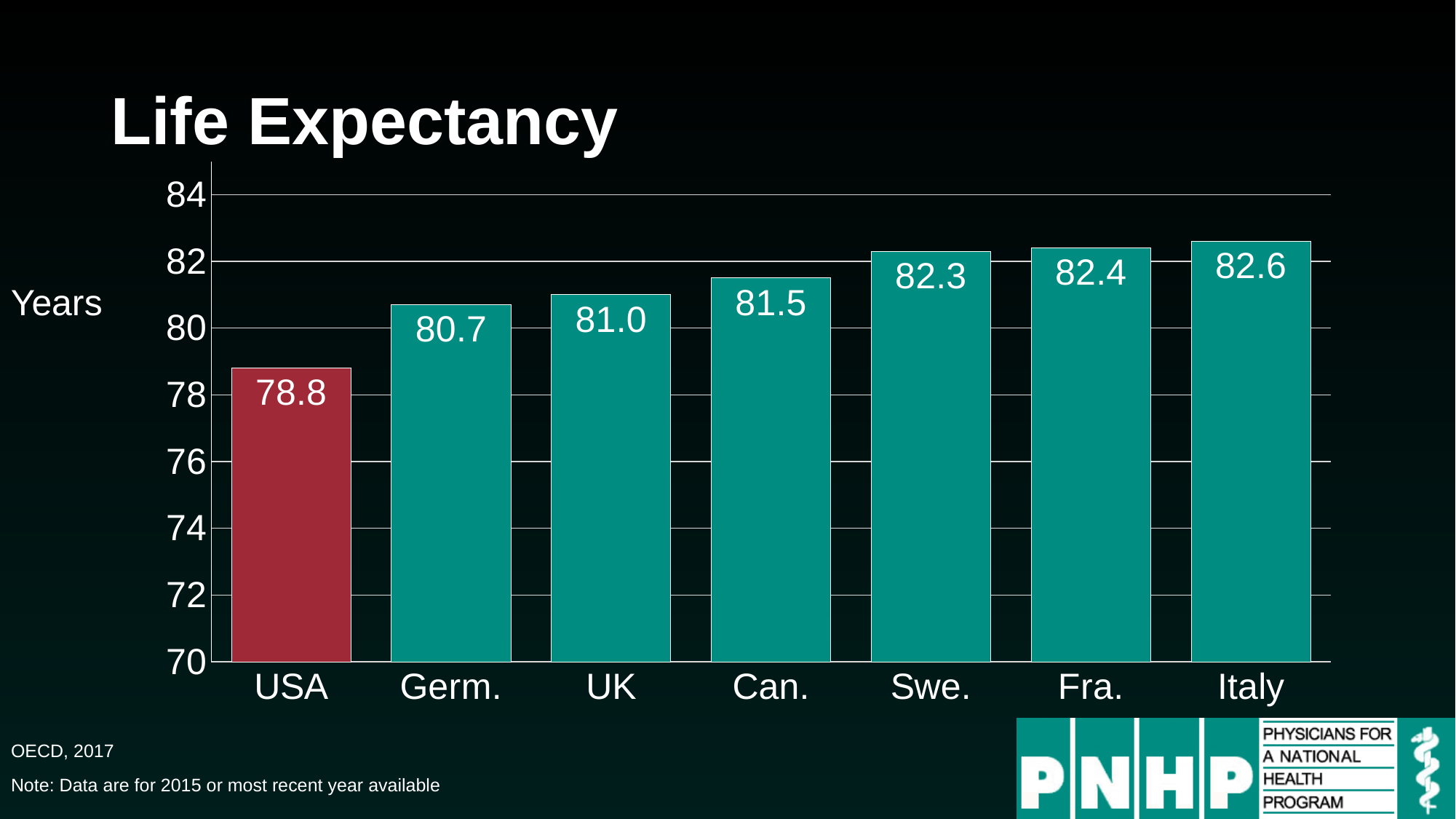
What kind of chart is shown on the slide? Bar chart How many countries are shown on the chart? 7 What is the difference in life expectancy between the UK and Germany (Germ.)? 0.3 Which bar is shown in a different colour (red) from the others? USA What is the life expectancy value shown for the USA? 78.8 Which has a higher life expectancy, Germany (Germ.) or Canada (Can.)? Canada (Can.) What is the life expectancy value shown for Canada (Can.)? 81.5 What is the difference in life expectancy between Italy and the USA? 3.8 What is the life expectancy value shown for Sweden (Swe.)? 82.3 Is the value for the USA greater or less than 80? less Which country has the lowest life expectancy on the chart? USA Which country has the highest life expectancy on the chart? Italy